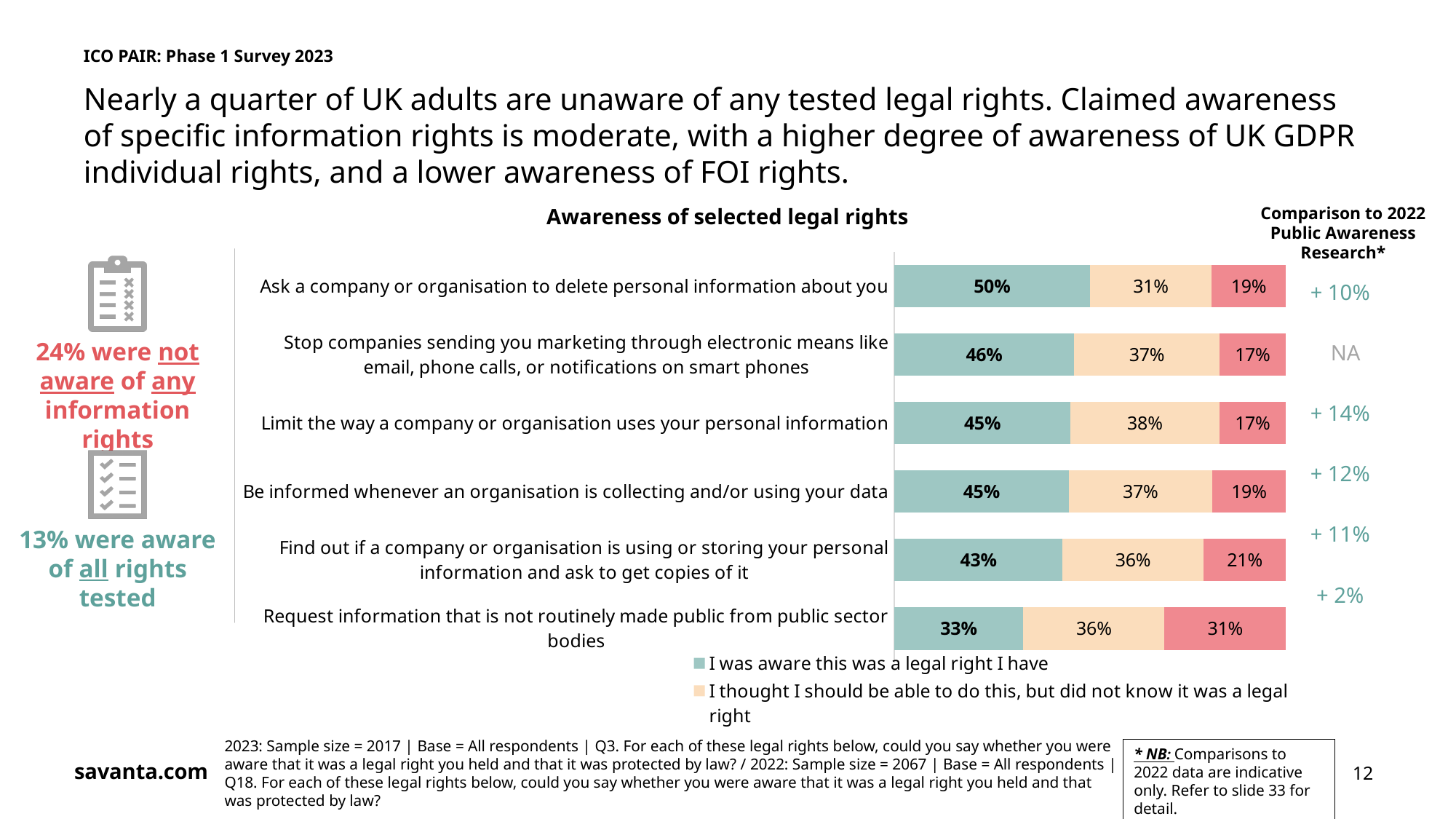
What is the difference between the 'aware' percentage for deleting personal information (50%) and for requesting information from public sector bodies (33%)? 17 percentage points What is the chart's title? Awareness of selected legal rights What percentage were aware that asking a company or organisation to delete personal information about you is a legal right? 50% Which legal right has the lowest share of respondents who were aware it was a legal right? Request information that is not routinely made public from public sector bodies What is the comparison to 2022 Public Awareness Research shown for 'Limit the way a company or organisation uses your personal information'? + 14% Which legal right has the highest share of respondents who were aware it was a legal right? Ask a company or organisation to delete personal information about you What percentage were aware that requesting information not routinely made public from public sector bodies is a legal right? 33% What is the first legend entry listed below the chart? I was aware this was a legal right I have Which has a larger 'aware' percentage: 'Stop companies sending you marketing through electronic means' or 'Find out if a company or organisation is using or storing your personal information'? Stop companies sending you marketing through electronic means How many legal rights (categories) are plotted in the chart? 6 What kind of chart is shown on the slide? Stacked bar chart For 'Limit the way a company or organisation uses your personal information', what percentage thought they should be able to do this but did not know it was a legal right? 38%